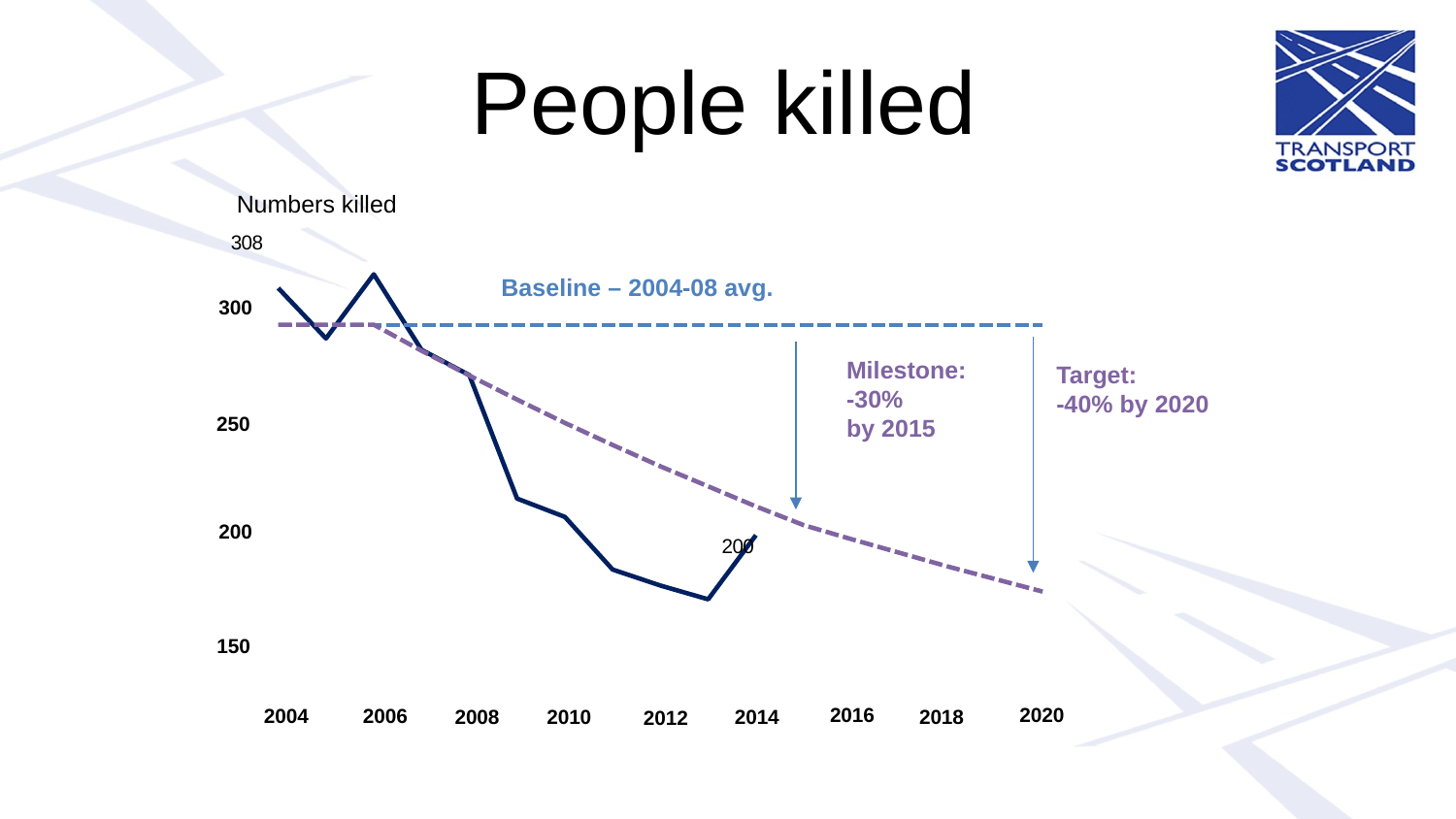
What is the label on the vertical axis of the chart? Numbers killed Is the value for 2013 greater or less than 200? less Is the value for 2008 greater or less than 250? greater Which year has the larger value, 2004 or 2008? 2004 Is the value for 2009 greater or less than 250? less In which year does the solid line reach its lowest value? 2013 What is the title of the chart? People killed Do the values of the solid line generally rise or fall from 2006 to 2013? fall What is the value of the solid line for 2014? 200 What kind of chart is shown on the slide? line chart In which year does the solid line reach its highest value? 2006